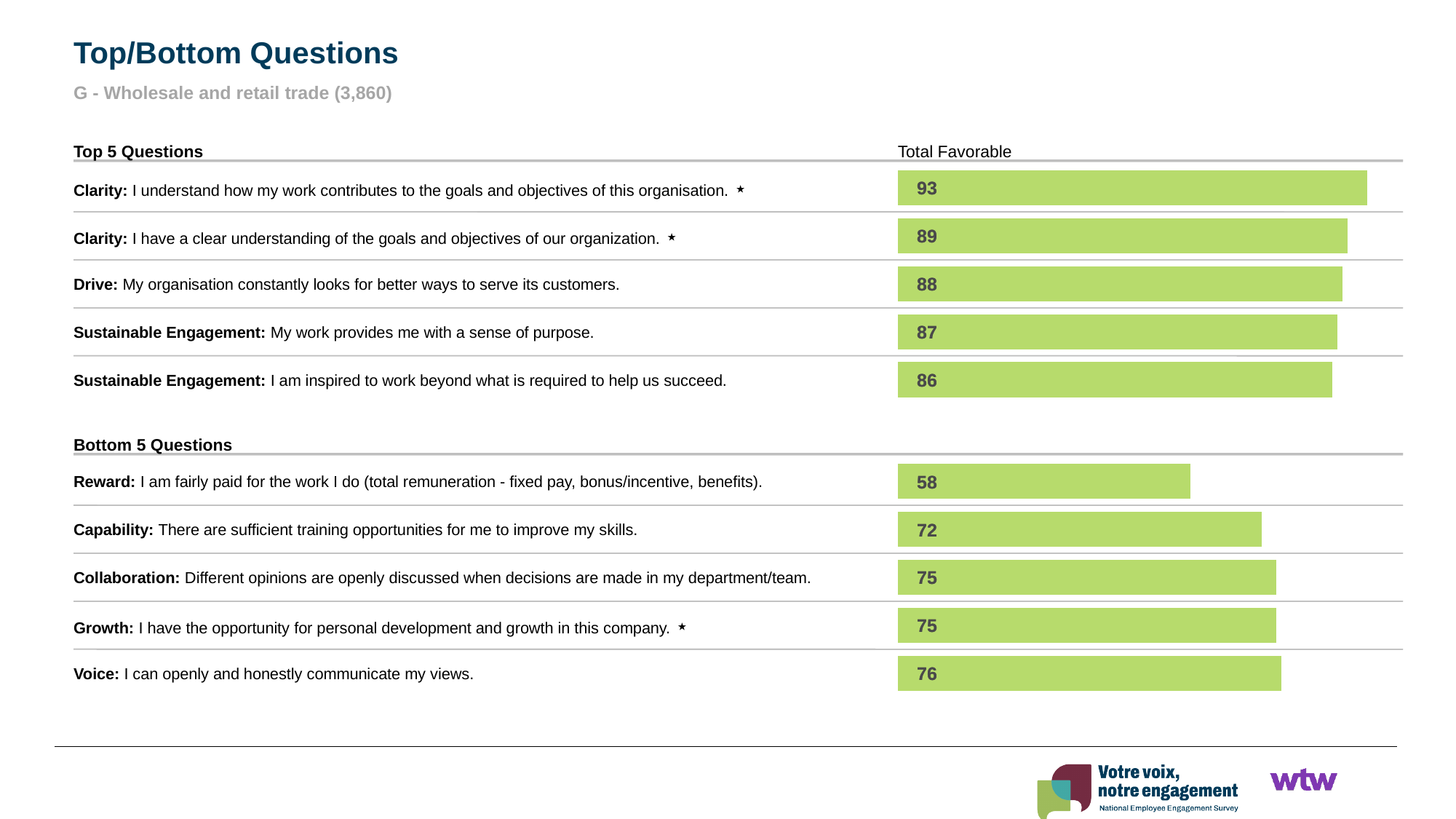
In the Bottom 5 Questions chart, what is the Total Favorable value for 'Voice: I can openly and honestly communicate my views.'? 76 In the Bottom 5 Questions chart, which question has the lowest Total Favorable value? Reward: I am fairly paid for the work I do (total remuneration - fixed pay, bonus/incentive, benefits). How many questions are shown in the Top 5 Questions chart? 5 In the Bottom 5 Questions chart, what is the Total Favorable value for 'Reward: I am fairly paid for the work I do'? 58 In the Top 5 Questions chart, what is the difference between the Total Favorable values for the two Clarity questions? 4 In the Bottom 5 Questions chart, which has a larger Total Favorable value: the Voice question or the Capability question? Voice In the Top 5 Questions chart, which question has the highest Total Favorable value? Clarity: I understand how my work contributes to the goals and objectives of this organisation. What is the subtitle shown under the slide title 'Top/Bottom Questions'? G - Wholesale and retail trade (3,860) In the Top 5 Questions chart, what is the Total Favorable value for 'Drive: My organisation constantly looks for better ways to serve its customers.'? 88 What kind of chart is used to show the Total Favorable values on this slide? Bar chart In the Bottom 5 Questions chart, what is the difference between the Total Favorable values for the Capability question and the Reward question? 14 In the Top 5 Questions chart, what is the Total Favorable value for 'Clarity: I understand how my work contributes to the goals and objectives of this organisation.'? 93